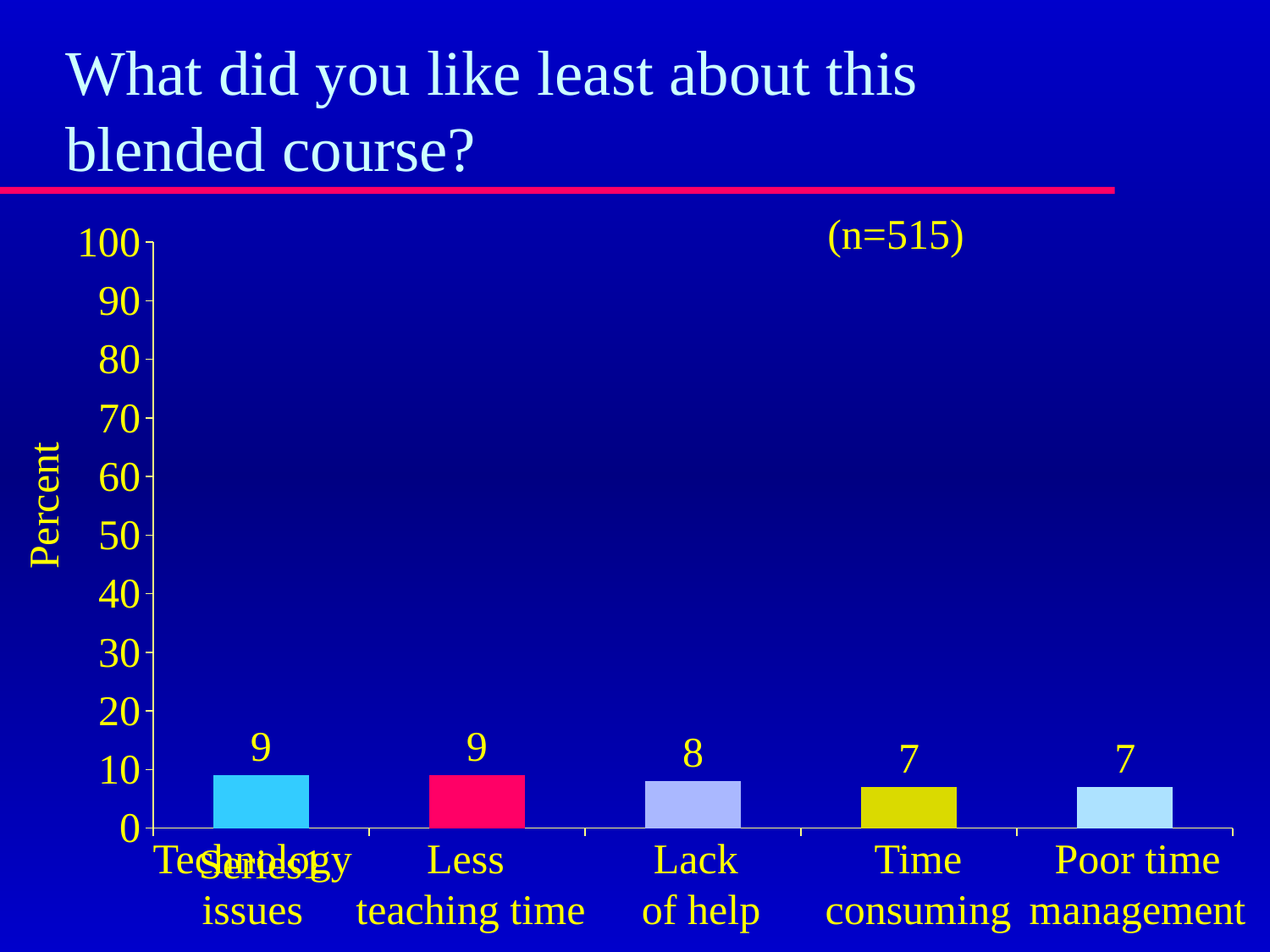
What is the value for Lack of help? 8 What is the difference between the values for Less teaching time and Lack of help? 1 What is the value for Technology issues? 9 What is the value for Less teaching time? 9 How many categories are shown on the x axis? 5 What is the value for Poor time management? 7 Is the value for Less teaching time greater or less than 20? less Which is larger, the value for Lack of help or the value for Poor time management? Lack of help What is the difference between the values for Technology issues and Time consuming? 2 What kind of chart is shown on the slide? bar chart What is the value for Time consuming? 7 What is the label of the y axis? Percent